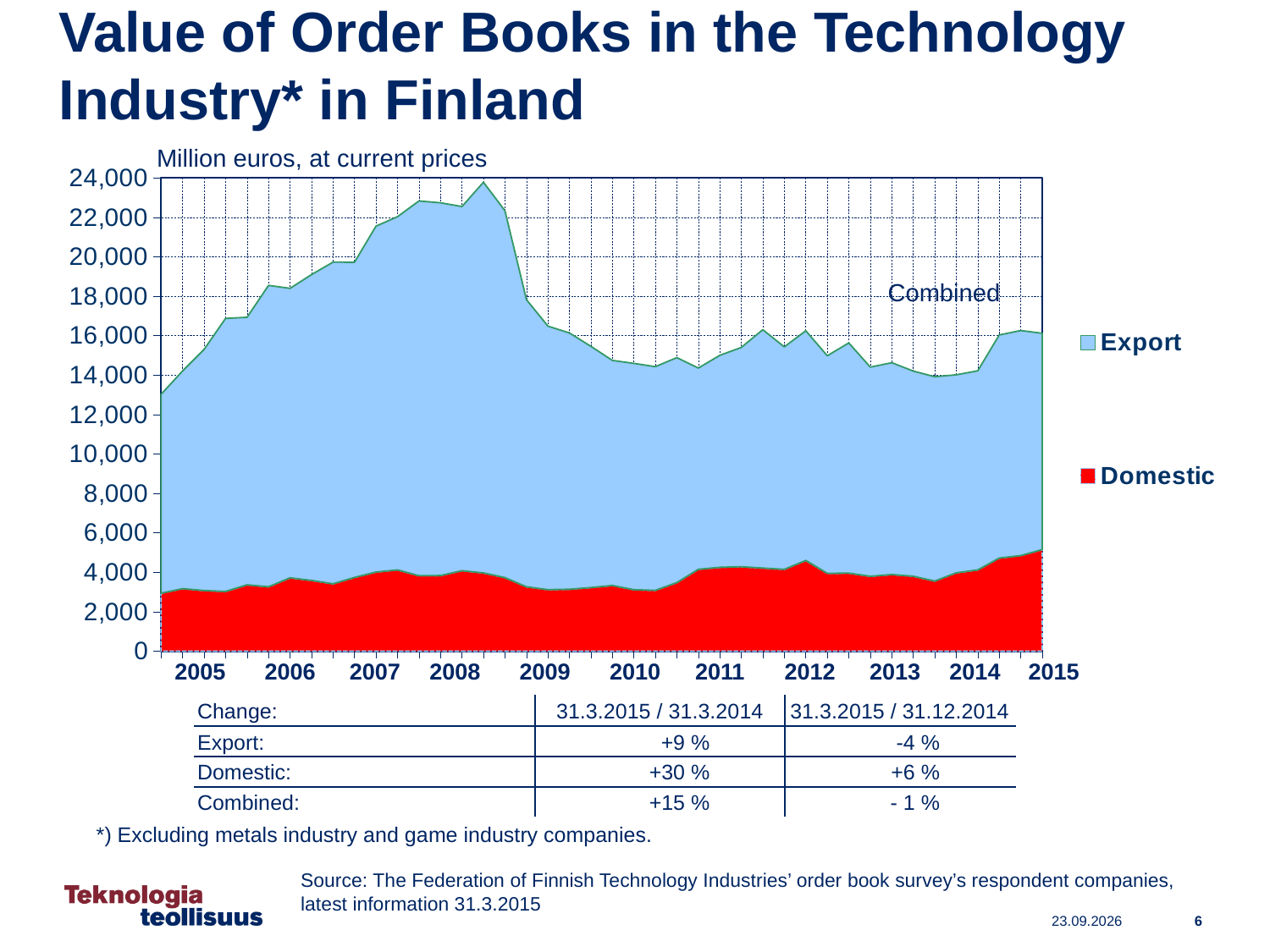
What kind of chart is shown on the slide? Area chart What unit is stated above the chart for the values plotted? Million euros, at current prices In which year does the combined value reach its highest point? 2008 Is the combined value during 2010 greater or less than 16,000? less How many year labels are shown on the x axis? 11 Is the Domestic value at the start of 2005 greater or less than 4,000? less Does the combined value rise or fall between its 2008 peak and 2009? fall Which two series are listed in the chart's legend? Export and Domestic How many series does the chart's legend list? 2 Is the peak combined value reached in 2008 greater or less than 22,000? greater